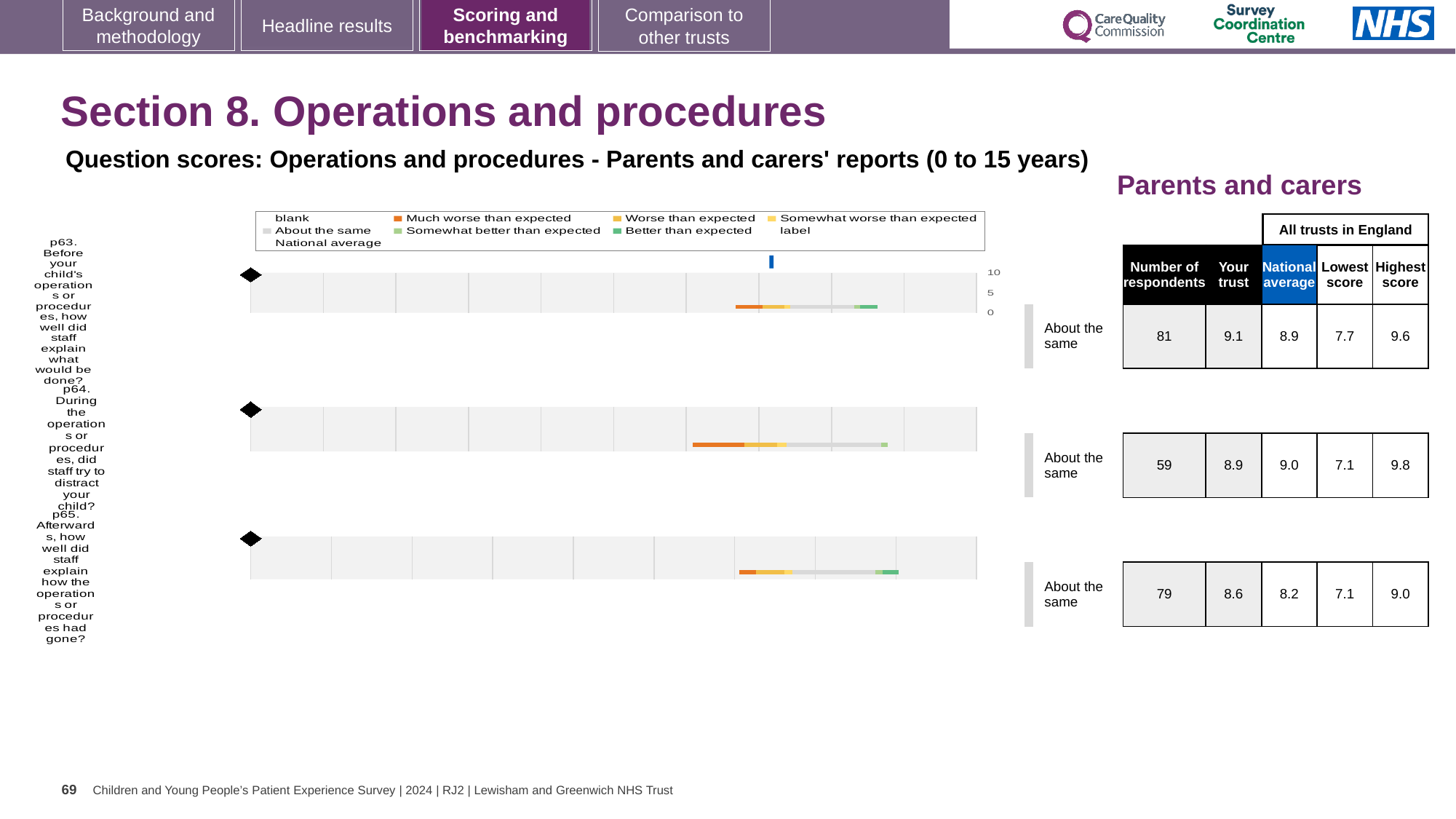
How many questions are charted on this slide? 3 What kind of chart is used to show the benchmarking results on this slide? Bar chart Which question has the highest 'Your trust' score on this slide? p63 How many respondents are shown for question p63 (Before your child's operations or procedures, how well did staff explain what would be done?)? 81 What is the national average score for question p65 (Afterwards, how well did staff explain how the operations or procedures had gone?)? 8.2 Which question has the lowest 'Your trust' score on this slide? p65 What is the highest score across all trusts in England for question p64? 9.8 For question p63, what is the difference between the highest score (9.6) and the lowest score (7.7) across all trusts in England? 1.9 What is the 'Your trust' score for question p64 (During the operations or procedures, did staff try to distract your child?)? 8.9 What benchmark category is shown for question p63? About the same For question p64, which is larger: the 'Your trust' score or the national average? National average What colour does the legend use for 'Much worse than expected'? Orange